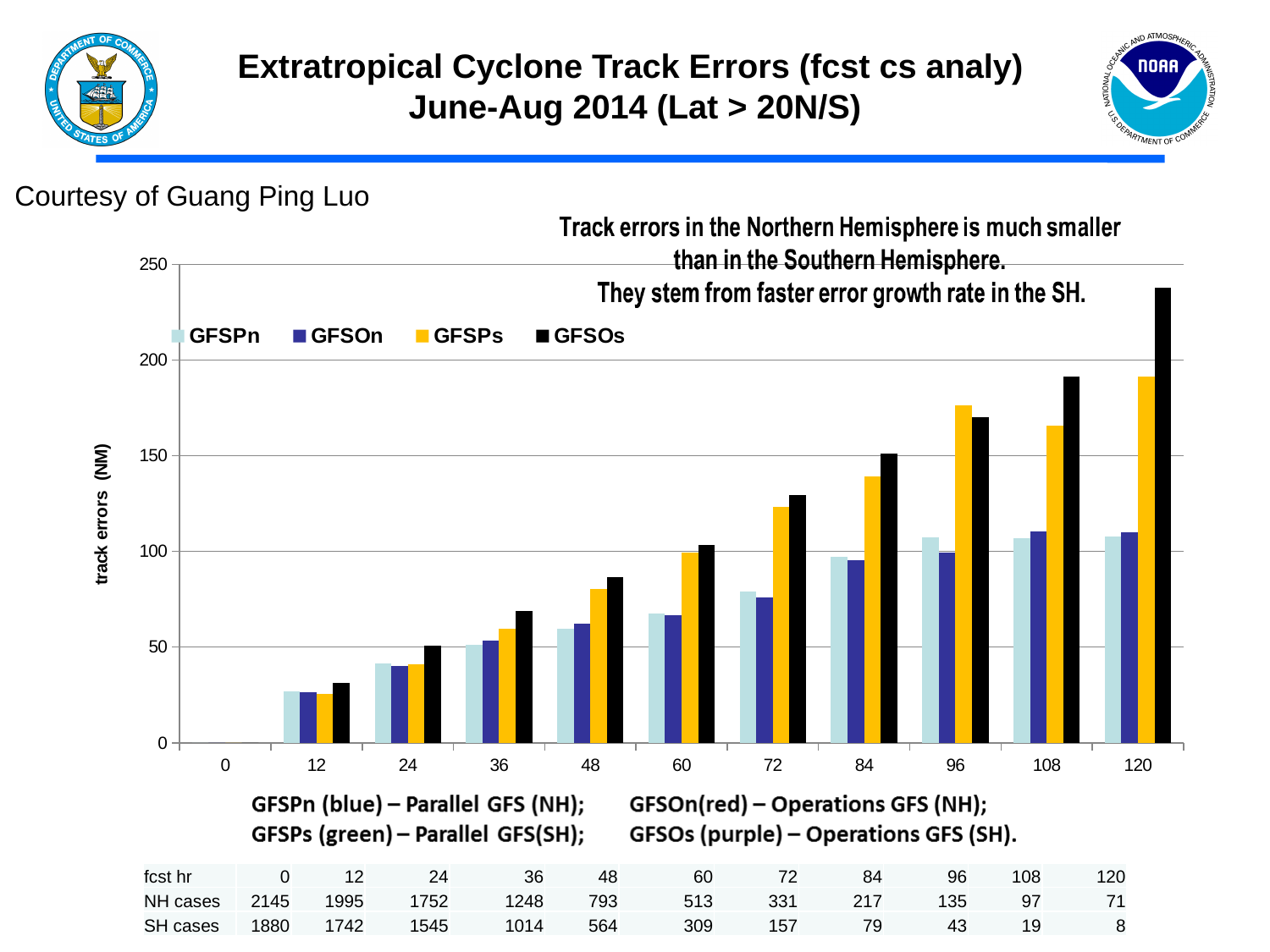
Is the GFSPs value at forecast hour 96 greater or less than 150? greater At which forecast hour is the GFSOs bar highest? 120 How many series does the chart legend list? 4 At forecast hour 120, which is larger: GFSOs or GFSPs? GFSOs Is the GFSOs value at forecast hour 120 greater or less than 200? greater What is the label on the y axis of the chart? track errors (NM) What kind of chart is shown on the slide? bar chart Is the GFSPn value at forecast hour 12 greater or less than 50? less At forecast hour 72, which is larger: GFSPs or GFSPn? GFSPs Do the GFSOs values rise or fall as the forecast hour increases? rise How many forecast-hour categories are shown along the x axis? 11